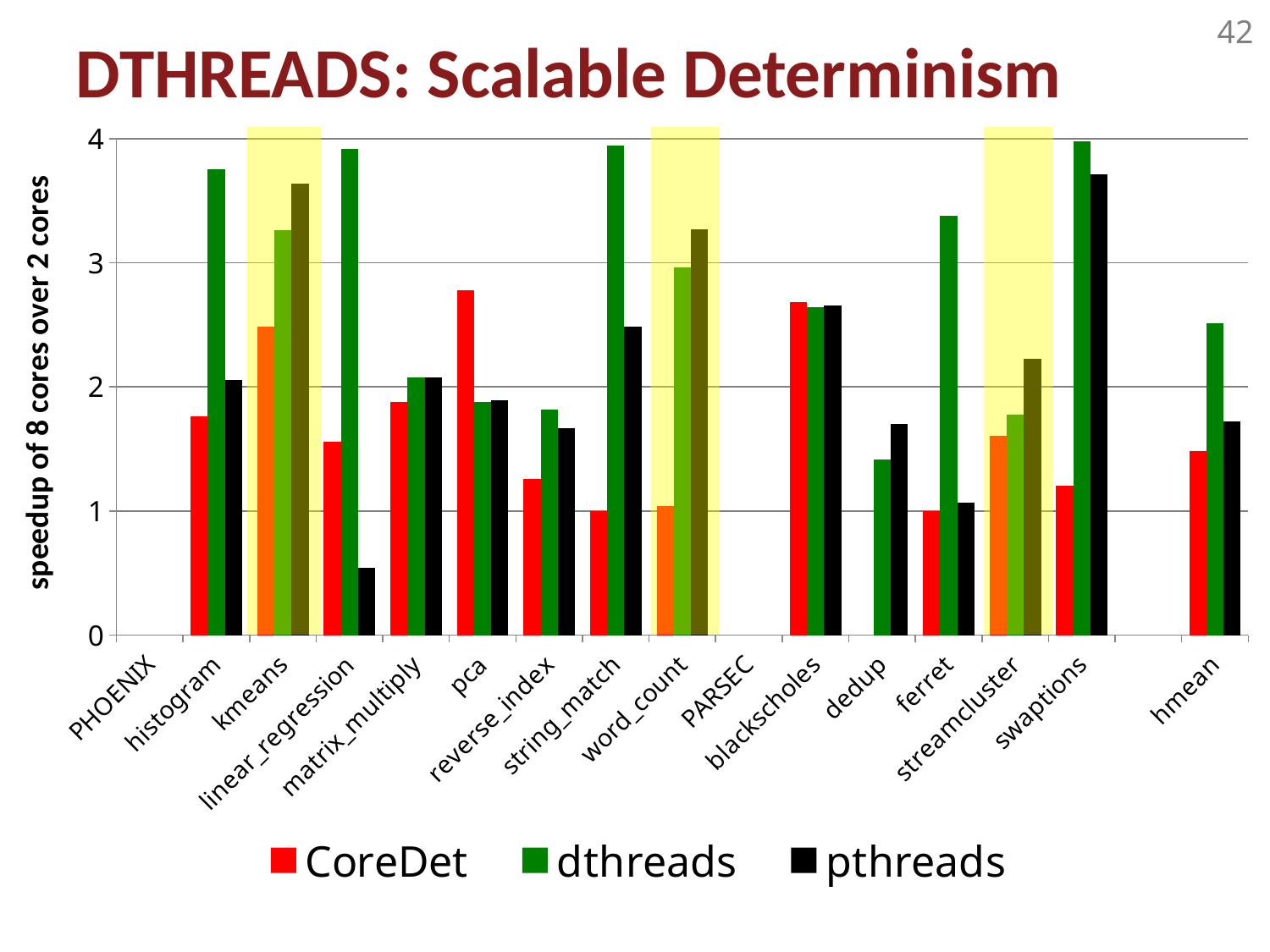
For linear_regression, which is larger: the dthreads value or the pthreads value? dthreads Is the pthreads value for swaptions greater or less than 3? greater What is the label on the vertical axis? speedup of 8 cores over 2 cores Is the dthreads value for histogram greater or less than 3? greater What kind of chart is shown on the slide? bar chart Is the pthreads value for linear_regression greater or less than 1? less How many series does the legend list? 3 For pca, which is larger: the CoreDet value or the dthreads value? CoreDet Which category has the lowest pthreads value? linear_regression Which colour represents the dthreads series in the legend? green